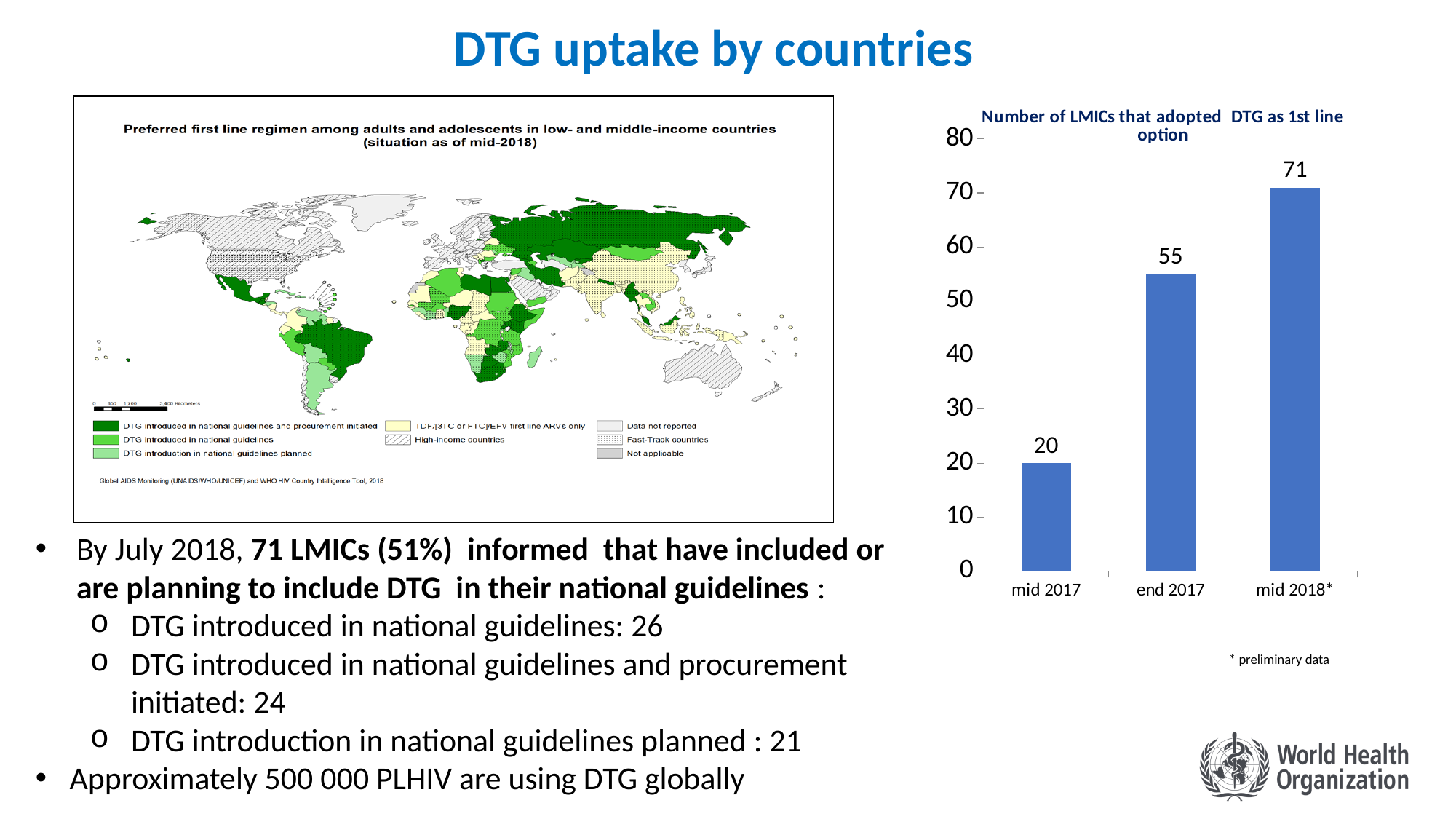
What is the value for mid 2018* in the bar chart? 71 What is the value for mid 2017 in the bar chart? 20 What is the difference between the values for mid 2018* and end 2017 in the bar chart? 16 What is the value for end 2017 in the bar chart? 55 What kind of chart is shown on the right of the slide? bar chart How many categories are shown on the x axis of the bar chart? 3 What is the title of the bar chart? Number of LMICs that adopted DTG as 1st line option Which is larger in the bar chart, the value for end 2017 or the value for mid 2017? end 2017 Which category has the highest value in the bar chart? mid 2018* What is the difference between the values for end 2017 and mid 2017 in the bar chart? 35 Do the values in the bar chart rise or fall from mid 2017 to mid 2018*? rise Which category has the lowest value in the bar chart? mid 2017